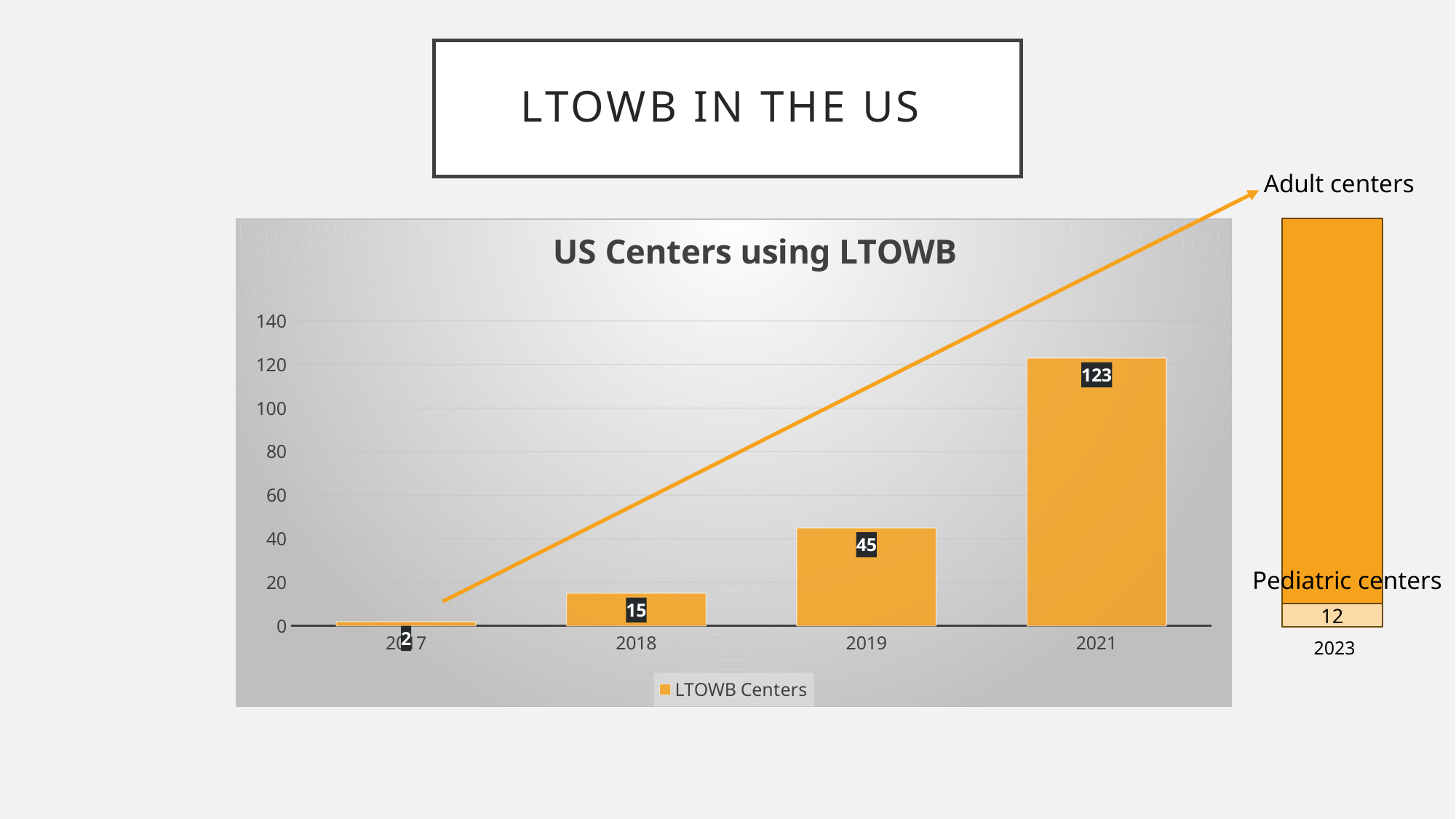
In the 'US Centers using LTOWB' chart, what is the difference between the values for 2019 and 2018? 30 In the 'US Centers using LTOWB' chart, which year has the lowest value? 2017 In the 2023 stacked bar on the right of the slide, what is the value for Pediatric centers? 12 In the 'US Centers using LTOWB' chart, what is the value for 2019? 45 In the 'US Centers using LTOWB' chart, what is the value for 2018? 15 In the 'US Centers using LTOWB' chart, what is the value for 2021? 123 What kind of chart is 'US Centers using LTOWB'? bar chart In the 'US Centers using LTOWB' chart, is the value for 2021 greater or less than 100? greater In the 'US Centers using LTOWB' chart, which year has the highest value? 2021 In the 'US Centers using LTOWB' chart, which is larger, the value for 2018 or the value for 2019? 2019 How many years are shown on the x axis of the 'US Centers using LTOWB' chart? 4 In the 'US Centers using LTOWB' chart, what is the difference between the values for 2021 and 2019? 78